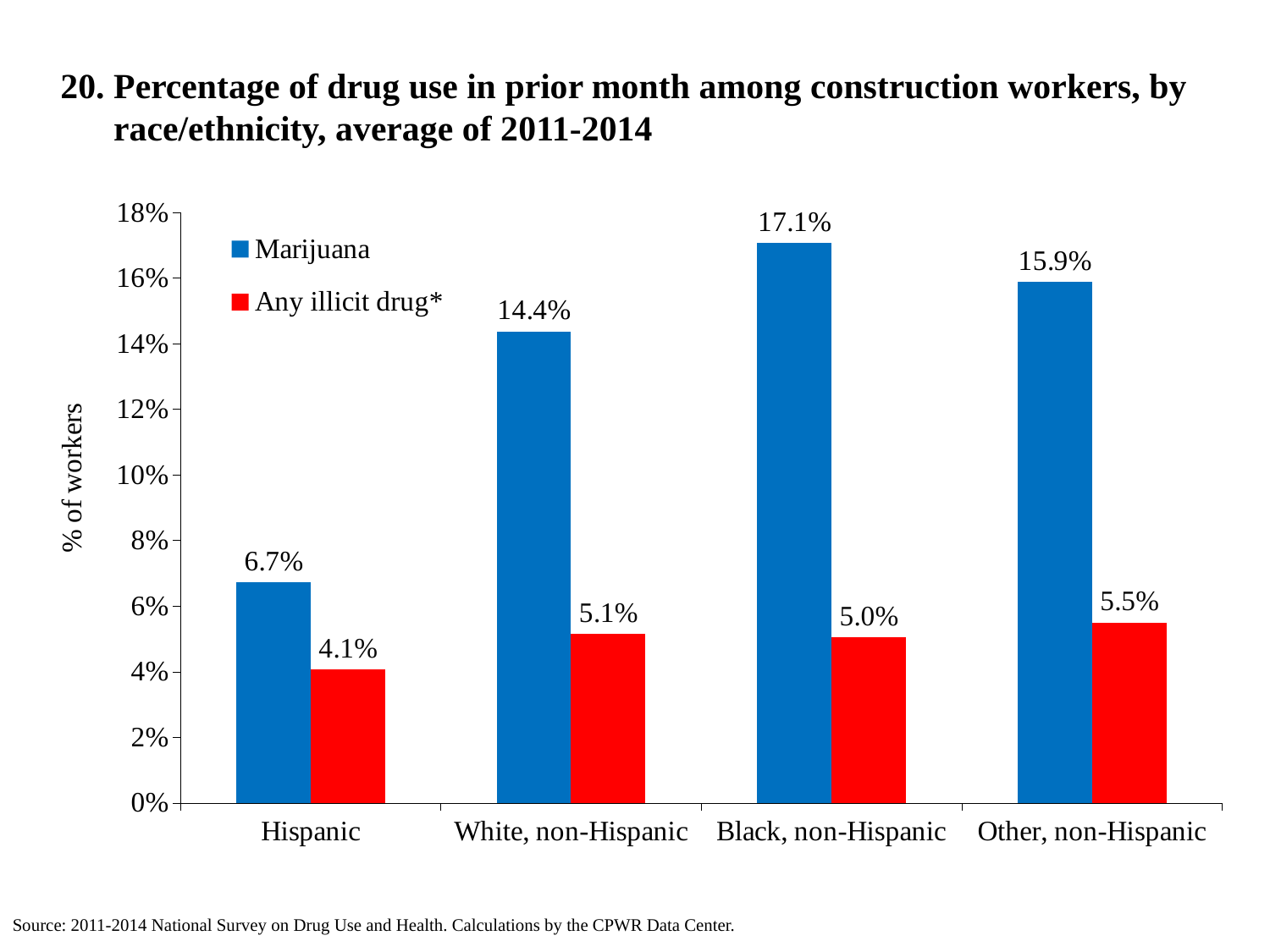
How many series does the legend list? 2 What kind of chart is shown on the slide? Bar chart What colour are the Any illicit drug* bars? Red Which is larger: the Any illicit drug* value for Other, non-Hispanic or for White, non-Hispanic workers? Other, non-Hispanic What is the Marijuana value for Hispanic construction workers? 6.7% Which race/ethnicity group has the highest Marijuana value? Black, non-Hispanic Which race/ethnicity group has the lowest Any illicit drug* value? Hispanic How many race/ethnicity categories are shown on the x axis? 4 What is the difference between the Marijuana values for Black, non-Hispanic and White, non-Hispanic workers? 2.7% What is the Marijuana value for Other, non-Hispanic construction workers? 15.9% What is the Any illicit drug* value for Black, non-Hispanic construction workers? 5.0% Is the Marijuana value for White, non-Hispanic workers greater or less than 10%? greater